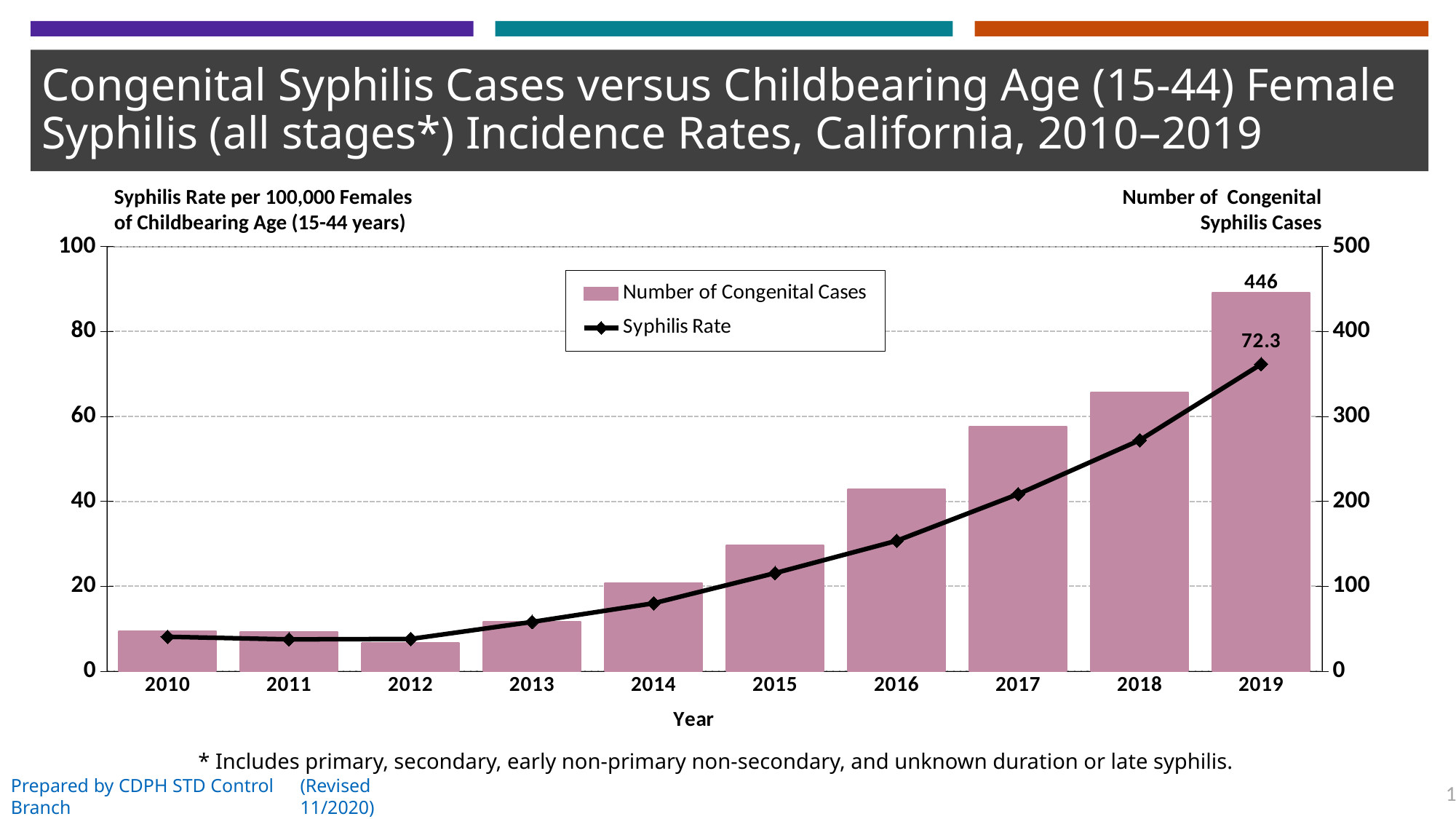
Does the syphilis rate rise or fall from 2012 to 2019? rises What is the number of congenital syphilis cases in 2019? 446 Which year has the highest number of congenital syphilis cases? 2019 Is the number of congenital cases in 2013 greater or less than 100? less How many years are shown on the x axis? 10 Is the number of congenital cases in 2018 greater or less than 300? greater Which year has the lowest number of congenital syphilis cases? 2012 Is the syphilis rate in 2016 greater or less than 40? less What kind of chart is this? Combination bar and line chart How many series does the legend list? 2 What is the syphilis rate per 100,000 females of childbearing age in 2019? 72.3 Which year has more congenital syphilis cases, 2017 or 2018? 2018